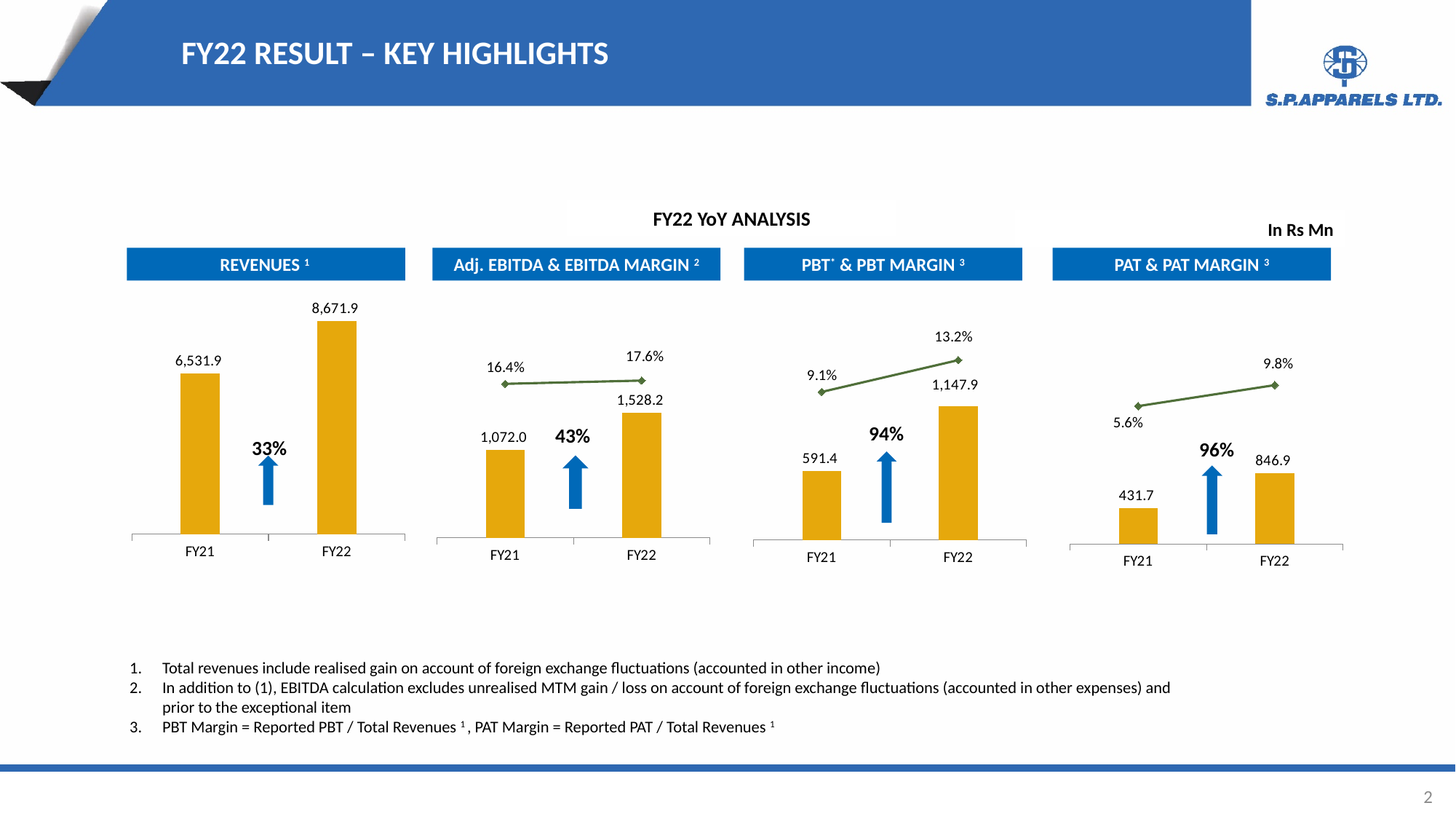
In the PBT & PBT MARGIN chart, what is the PBT value for FY21? 591.4 In the PBT & PBT MARGIN chart, what is the PBT margin for FY22? 13.2% In the PAT & PAT MARGIN chart, what is the difference between the FY22 and FY21 PAT values? 415.2 In the Adj. EBITDA & EBITDA MARGIN chart, what is the EBITDA margin for FY21? 16.4% In the PAT & PAT MARGIN chart, what is the PAT value for FY22? 846.9 In the PAT & PAT MARGIN chart, which year has the higher PAT margin, FY21 or FY22? FY22 In the PBT & PBT MARGIN chart, does the PBT margin rise or fall from FY21 to FY22? rise In the REVENUES chart, what is the value for FY22? 8,671.9 How many categories are shown on the x axis of the REVENUES chart? 2 In the REVENUES chart, what is the difference between the FY22 and FY21 values? 2,140.0 In the REVENUES chart, what is the value for FY21? 6,531.9 In the Adj. EBITDA & EBITDA MARGIN chart, what is the Adj. EBITDA value for FY22? 1,528.2